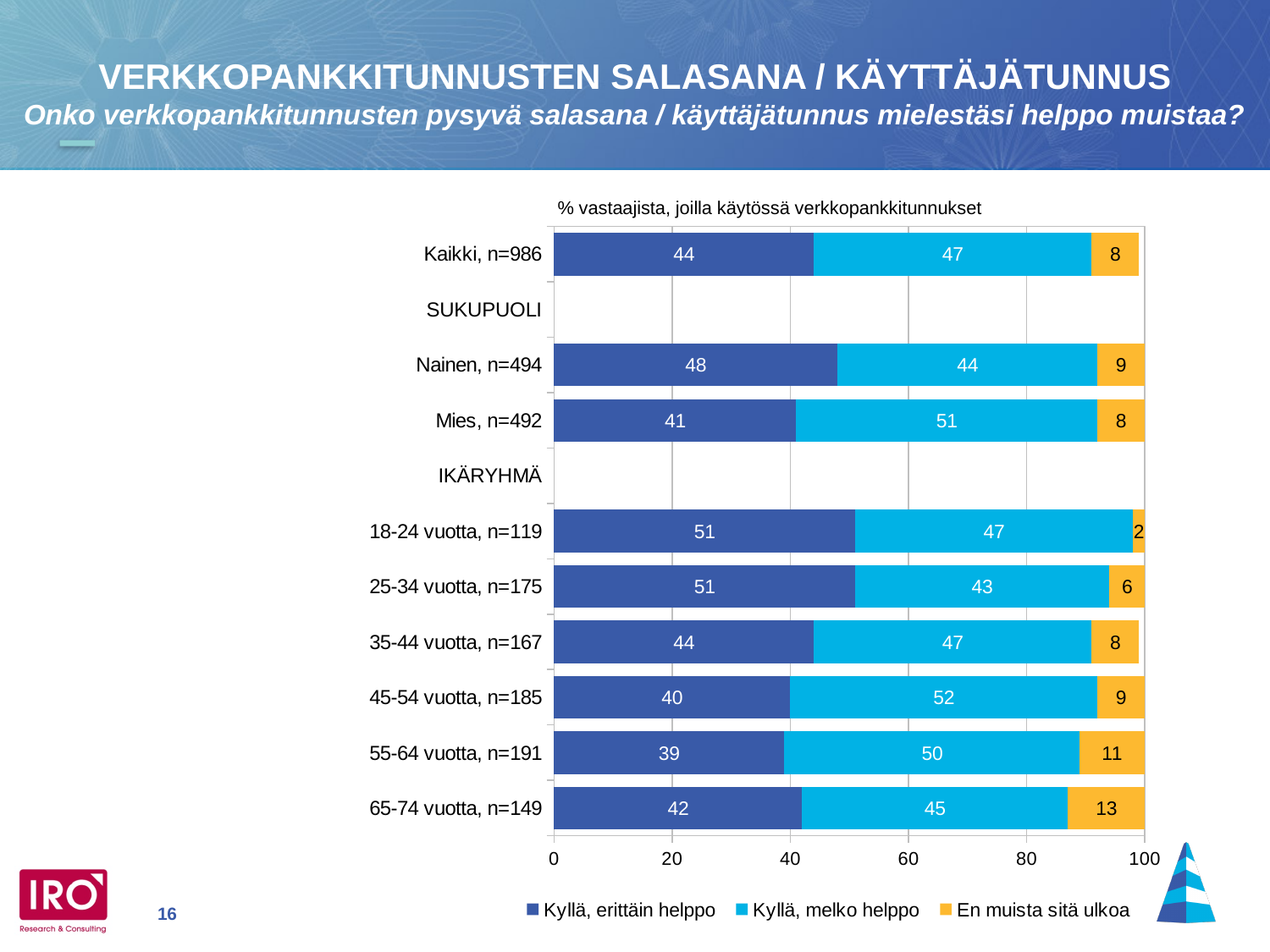
What is the total of the stacked bar for 55-64 vuotta, n=191? 100 How many series does the legend list? 3 What is the value of "En muista sitä ulkoa" for 65-74 vuotta, n=149? 13 What is the difference between the "Kyllä, erittäin helppo" values for Nainen, n=494 and Mies, n=492? 7 Which is larger: the "Kyllä, melko helppo" value for 45-54 vuotta, n=185 or for 25-34 vuotta, n=175? 45-54 vuotta, n=185 Which category has the highest value for "En muista sitä ulkoa"? 65-74 vuotta, n=149 What is the text shown above the chart describing the values? % vastaajista, joilla käytössä verkkopankkitunnukset What is the value of "Kyllä, erittäin helppo" for Kaikki, n=986? 44 Which category has the lowest value for "En muista sitä ulkoa"? 18-24 vuotta, n=119 How many data bars (categories with values) are plotted in the chart? 9 What is the value of "Kyllä, melko helppo" for Mies, n=492? 51 What kind of chart is shown on the slide? Stacked bar chart